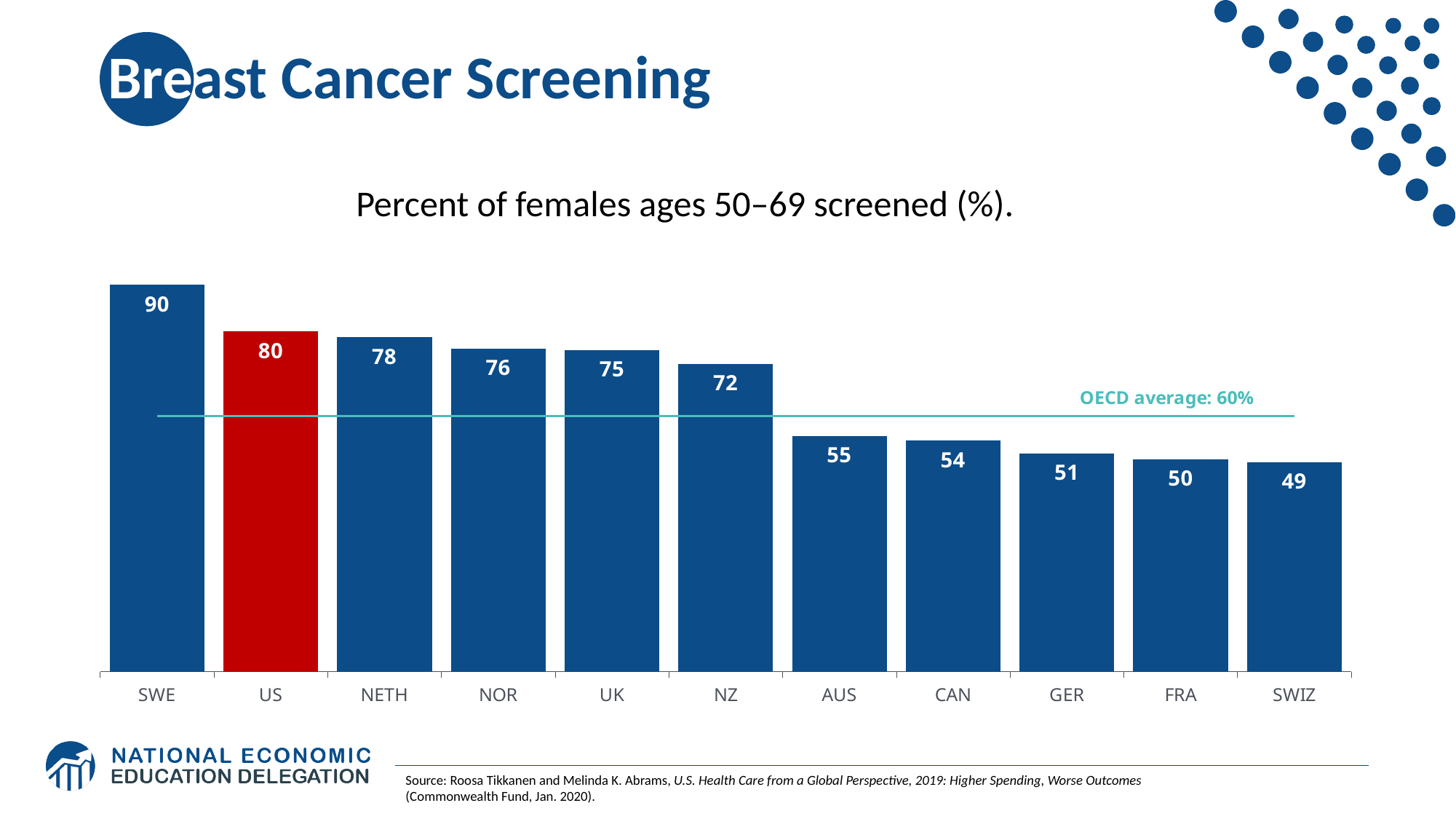
What is the difference between the values for SWE and the US? 10 What OECD average is marked by the horizontal line on the chart? 60% What kind of chart is this? Bar chart How many countries are shown on the chart? 11 Do the values rise or fall from left to right along the x axis? Fall Which country has the lowest value? SWIZ Which country has the highest value? SWE Which is larger, the value for NOR or the value for CAN? NOR What is the difference between the values for NETH and AUS? 23 What is the value for NZ? 72 What is the value for FRA? 50 What is the value for the US? 80